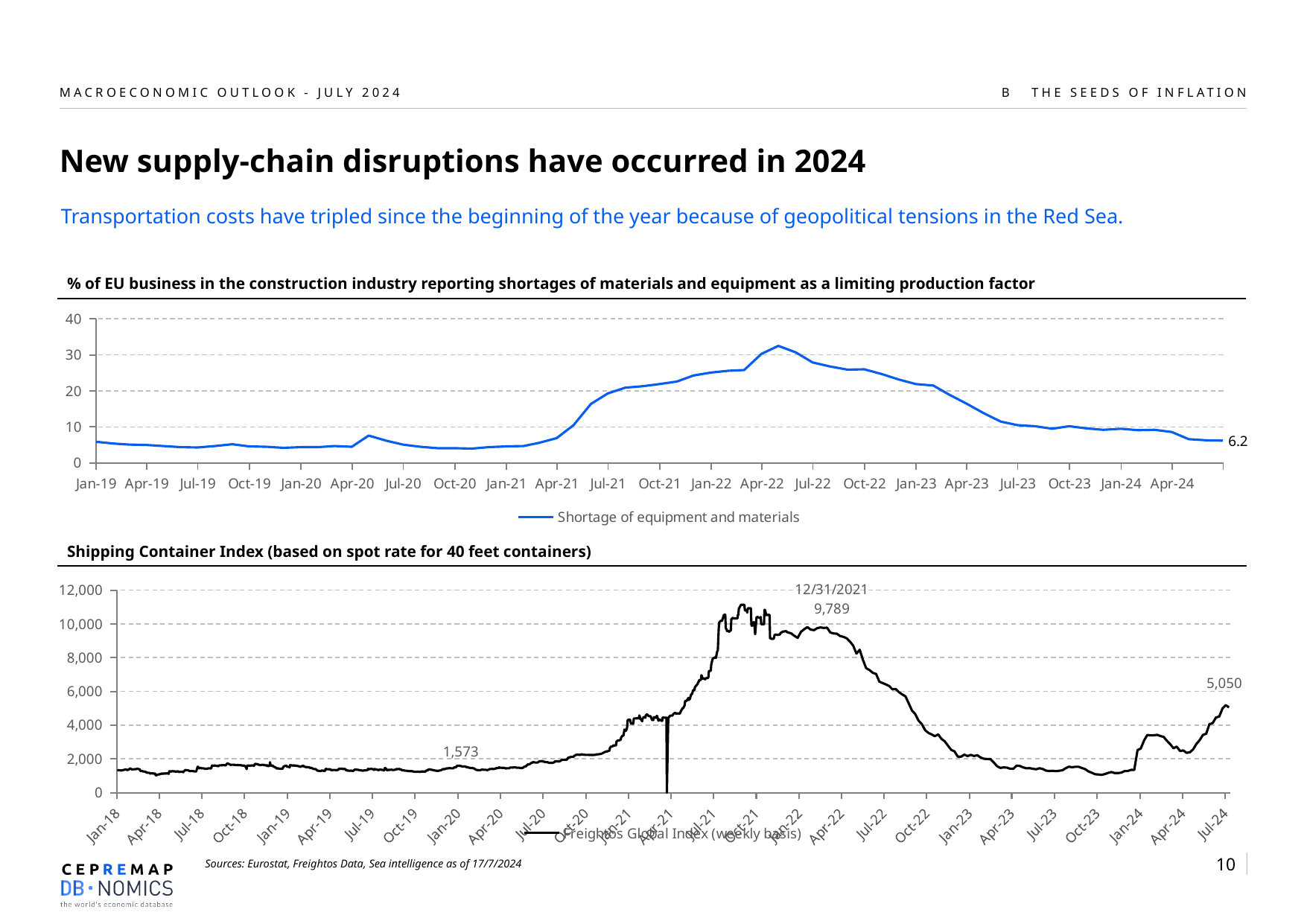
In the bottom chart, the Shipping Container Index, what is the latest value labelled at the end of the line in Jul-24? 5,050 In the bottom chart, the Shipping Container Index, is the value at Jan-18 greater or less than 2,000? less What series name does the legend of the bottom chart, the Shipping Container Index, show? Freightos Global Index (weekly basis) In the bottom chart, the Shipping Container Index, which is larger: the labelled value of 1,573 or the latest labelled value of 5,050? 5,050 In the top chart on shortages of materials and equipment, is the peak value reached around mid-2022 greater or less than 30? greater In the bottom chart, the Shipping Container Index, what value is labelled for 12/31/2021? 9,789 In the bottom chart, the Shipping Container Index, what is the difference between the labelled peak of 9,789 on 12/31/2021 and the latest labelled value of 5,050? 4,739 In the top chart on shortages of materials and equipment, what is the latest value labelled at the end of the line? 6.2 How many series does the legend of the top chart on shortages of materials and equipment list? 1 In the top chart on shortages of materials and equipment, is the value at Jan-19 greater or less than 10? less What kind of chart is the top chart, '% of EU business in the construction industry reporting shortages of materials and equipment as a limiting production factor'? Line chart In the top chart on shortages of materials and equipment, do the values rise or fall between Jul-22 and Apr-24? fall